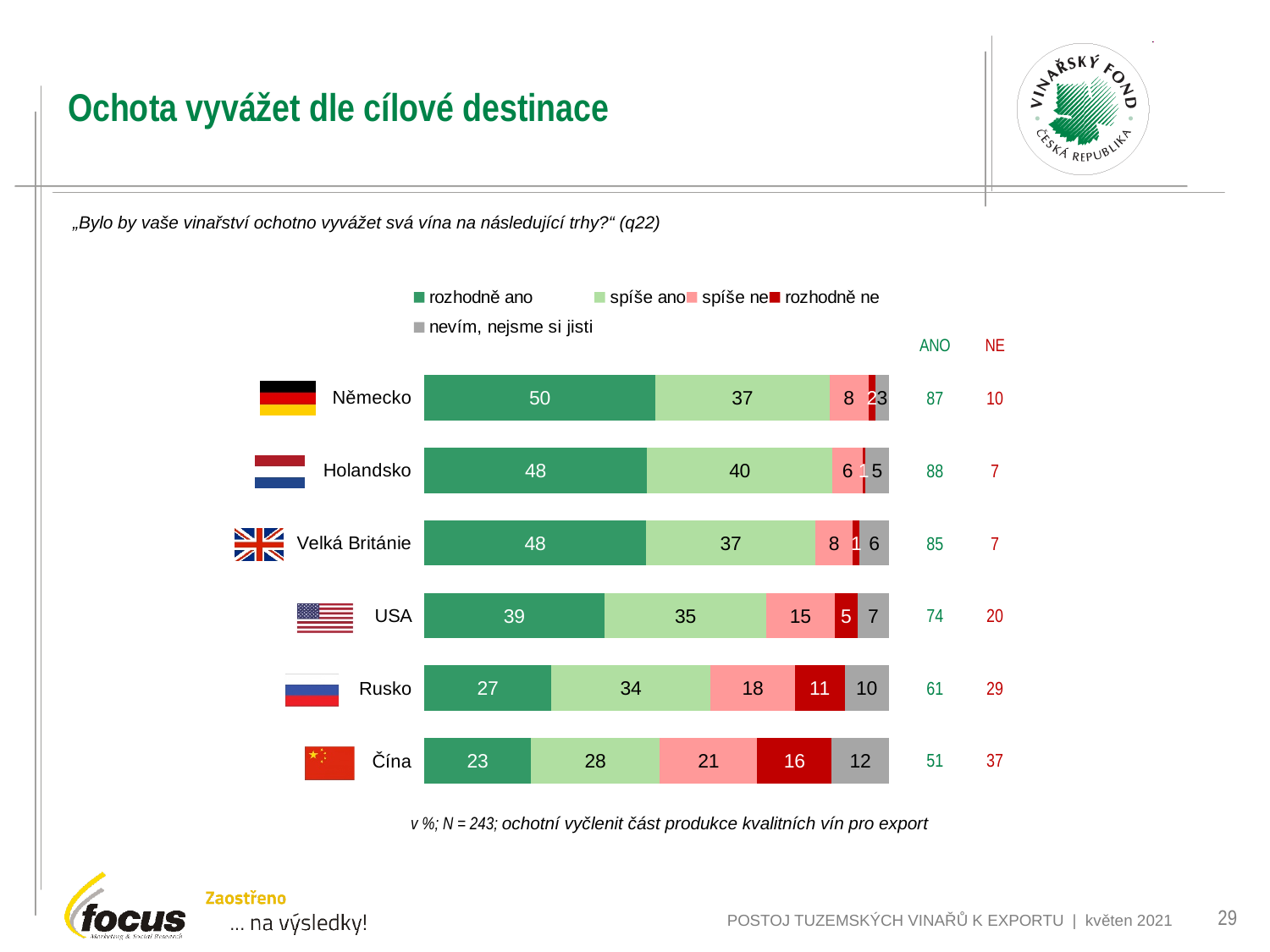
What is the total of the "rozhodně ano" and "spíše ano" segments for USA? 74 How many series does the legend list? 5 What kind of chart is shown on the slide? Stacked bar chart What is the value of "spíše ano" for Holandsko? 40 What is the value of "rozhodně ne" for Čína? 16 What is the value of "nevím, nejsme si jisti" for Rusko? 10 What is the value of "rozhodně ano" for Německo? 50 Which is larger: the "rozhodně ne" value for Rusko or for USA? Rusko How many countries are shown in the chart? 6 What is the difference between the "spíše ne" values for Čína and USA? 6 Which country has the highest value for "rozhodně ano"? Německo Which country has the lowest value for "rozhodně ano"? Čína